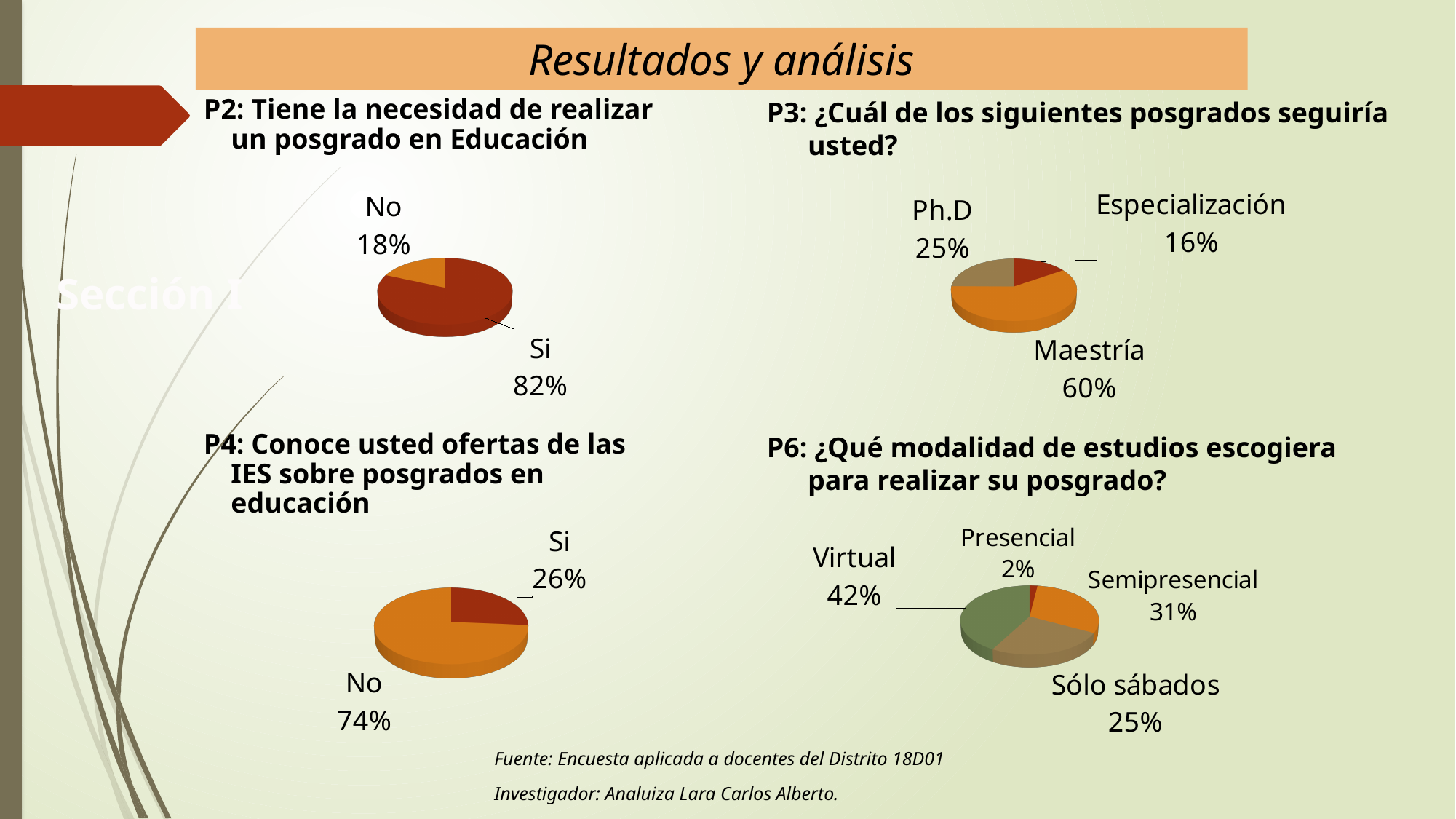
In the P4 chart (bottom left), which answer is larger, 'Si' or 'No'? No In the P3 chart (top right), which option has the lowest percentage? Especialización What type of chart is used for the P2 question (top left)? Pie chart In the P2 chart (top left), what percentage answered 'Si'? 82% In the P6 chart (bottom right), what is the difference between 'Semipresencial' and 'Sólo sábados'? 6% In the P4 chart (bottom left), what percentage answered 'No'? 74% In the P3 chart (top right), what is the difference between 'Ph.D' and 'Especialización'? 9% In the P6 chart (bottom right), which modality has the highest percentage? Virtual In the P6 chart (bottom right), what percentage chose 'Virtual'? 42% In the P3 chart (top right), what share of the pie is 'Maestría'? 60% In the P2 chart (top left), what percentage answered 'No'? 18% In the P6 chart (bottom right), how many modalities are shown? 4